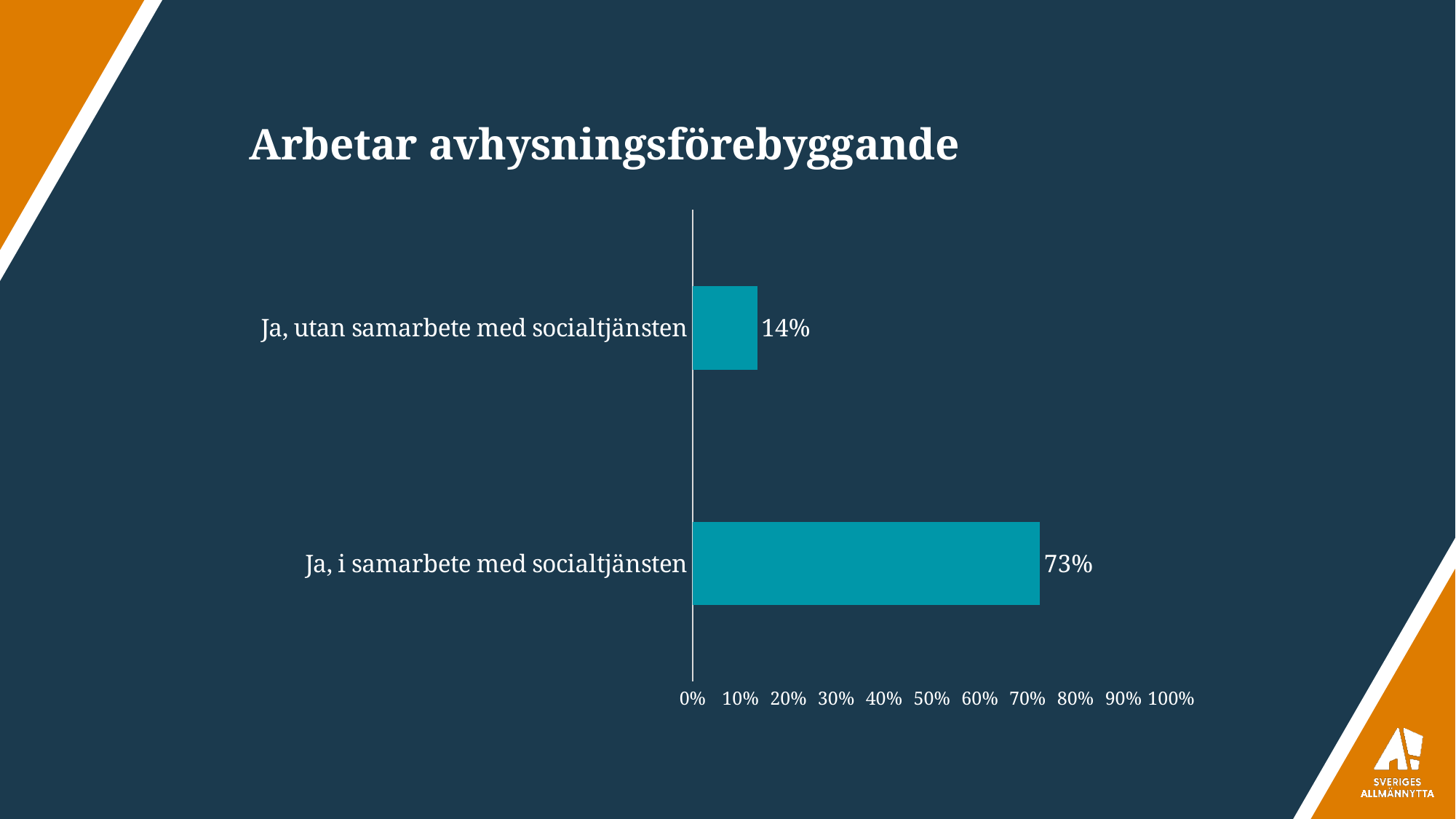
Is the value for "Ja, i samarbete med socialtjänsten" greater or less than 50%? greater What kind of chart is shown on the slide? bar chart Is the value for "Ja, utan samarbete med socialtjänsten" greater or less than 20%? less What is the value for "Ja, utan samarbete med socialtjänsten"? 14% Which category has the highest value? Ja, i samarbete med socialtjänsten What is the maximum value shown on the x axis? 100% Which is larger: the value for "Ja, i samarbete med socialtjänsten" or "Ja, utan samarbete med socialtjänsten"? Ja, i samarbete med socialtjänsten What is the title of the slide? Arbetar avhysningsförebyggande Which category has the lowest value? Ja, utan samarbete med socialtjänsten How many categories are shown in the chart? 2 What is the value for "Ja, i samarbete med socialtjänsten"? 73% What is the difference between the values for "Ja, i samarbete med socialtjänsten" and "Ja, utan samarbete med socialtjänsten"? 59%